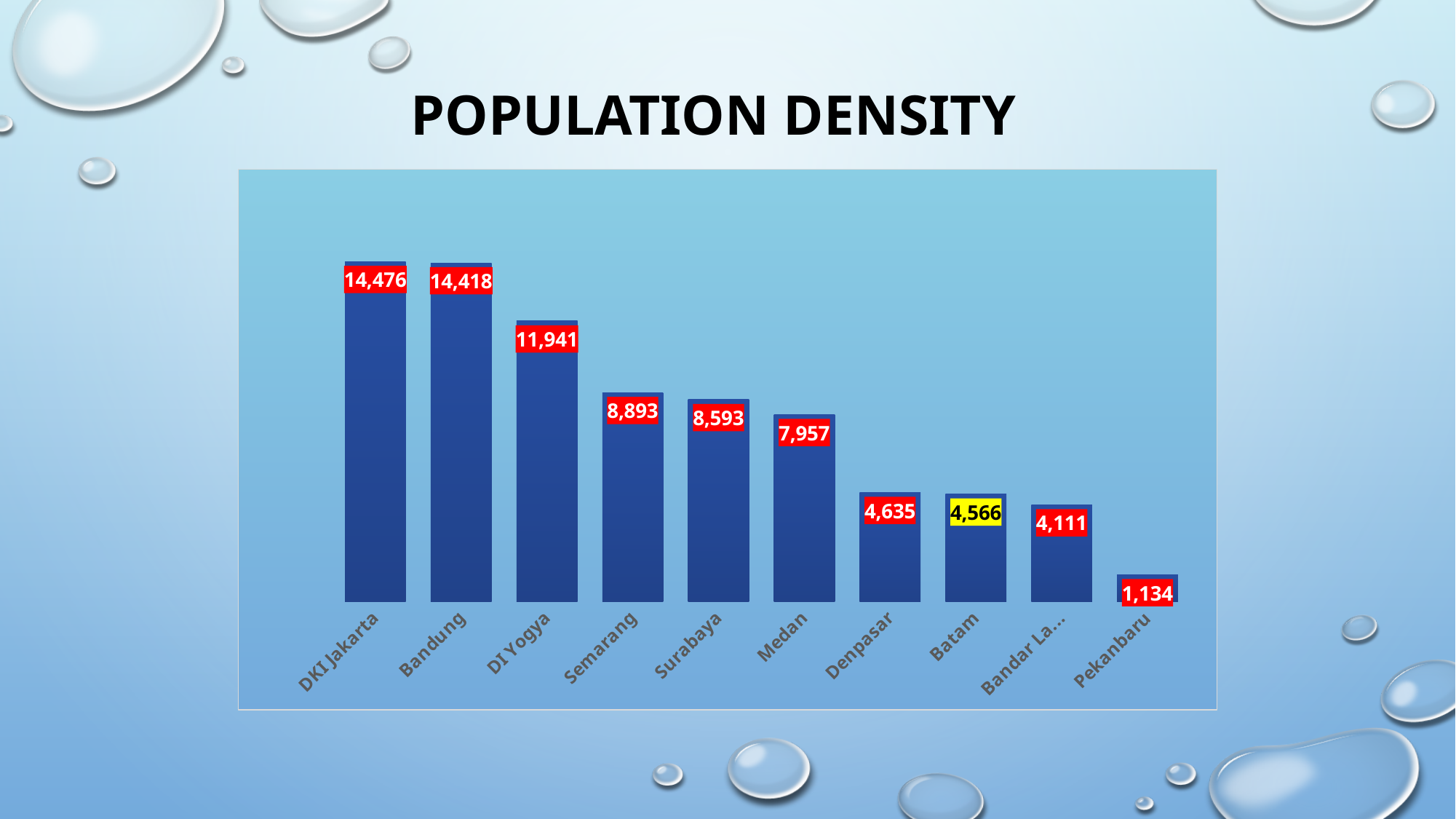
What value is shown for Medan? 7,957 Which has the larger value, Denpasar or Batam? Denpasar Which city's data label is highlighted in yellow instead of red? Batam How many cities are shown on the chart? 10 What is the population density value shown for DKI Jakarta? 14,476 What value is shown for Batam? 4,566 What value is shown for Semarang? 8,893 What is the difference between the values for Semarang and Surabaya? 300 Which city has the highest population density on the chart? DKI Jakarta Which city has the lowest population density on the chart? Pekanbaru What kind of chart is shown on the slide? Bar chart What is the difference between the values for DKI Jakarta and Bandung? 58